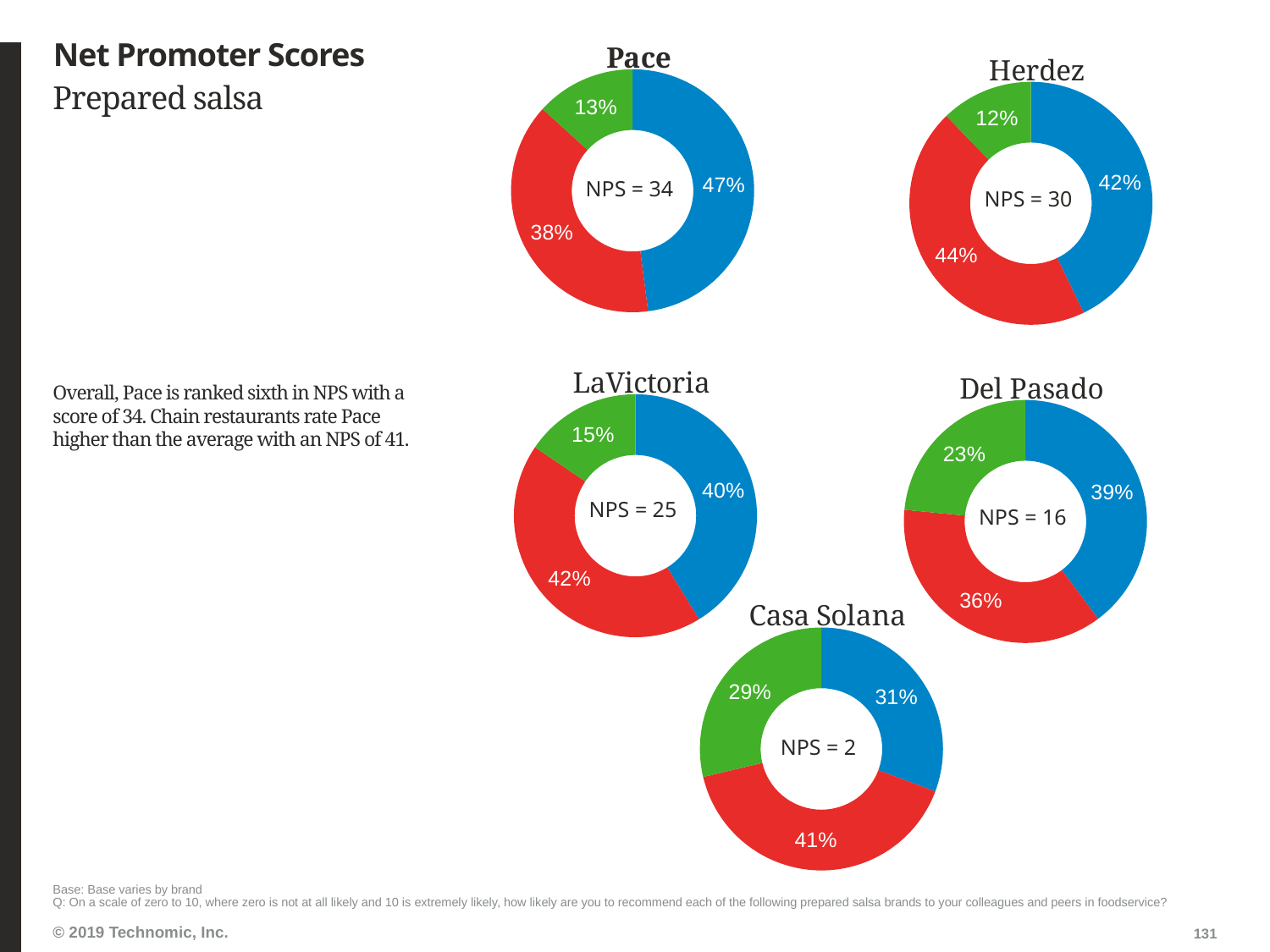
What kind of chart is used for each brand on this slide? Donut (pie) chart How many slices does the Casa Solana chart have? 3 In the Pace chart, what is the difference between the blue slice and the green slice? 34 percentage points In the Herdez chart, what percentage is shown for the red slice? 44% Which brand's chart has the lowest NPS value printed in its centre? Casa Solana (NPS = 2) Which chart shows a larger blue slice, Herdez or Casa Solana? Herdez What NPS value is printed in the centre of the Del Pasado chart? NPS = 16 In the LaVictoria chart, which slice is the largest? The red slice (42%) How many donut charts are shown on the slide? 5 In the Casa Solana chart, what percentage is shown for the green slice? 29% In the Del Pasado chart, which slice is the smallest? The green slice (23%) In the Pace chart, what percentage is shown for the blue slice? 47%